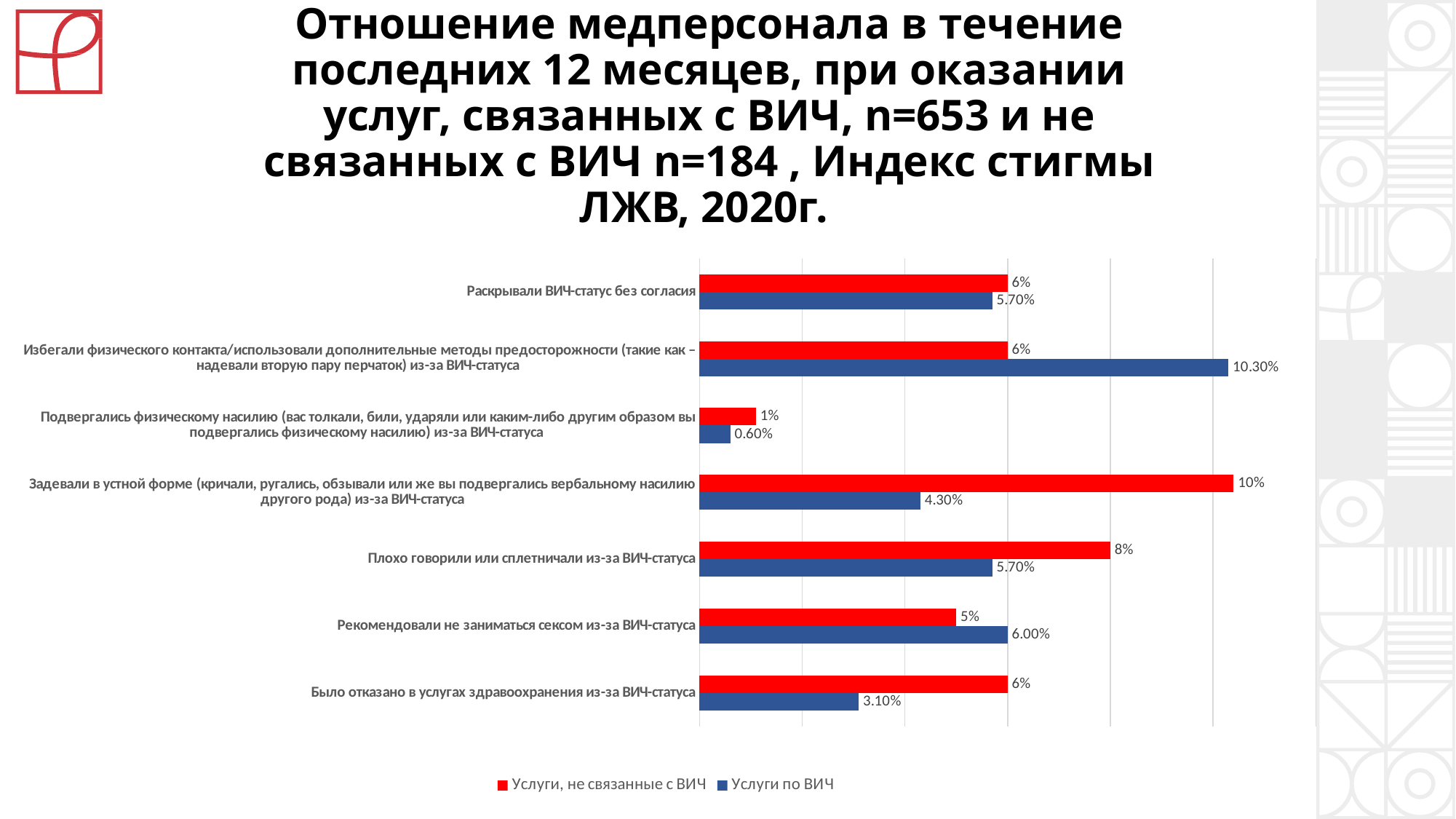
What kind of chart is shown on the slide? Bar chart What is the difference between the "Услуги по ВИЧ" values for "Избегали физического контакта..." and "Было отказано в услугах здравоохранения из-за ВИЧ-статуса"? 7.20% How many series does the legend list? 2 In the category "Рекомендовали не заниматься сексом из-за ВИЧ-статуса", which series has the larger value? Услуги по ВИЧ How many categories are shown on the chart? 7 What is the difference between the "Услуги, не связанные с ВИЧ" values for "Задевали в устной форме..." and "Подвергались физическому насилию..."? 9% What value is shown for "Услуги, не связанные с ВИЧ" in the category "Задевали в устной форме (кричали, ругались, обзывали или же вы подвергались вербальному насилию другого рода) из-за ВИЧ-статуса"? 10% What value is shown for "Услуги по ВИЧ" in the category "Избегали физического контакта/использовали дополнительные методы предосторожности (такие как – надевали вторую пару перчаток) из-за ВИЧ-статуса"? 10.30% What value is shown for "Услуги по ВИЧ" in the category "Было отказано в услугах здравоохранения из-за ВИЧ-статуса"? 3.10% Which category has the lowest value for the "Услуги, не связанные с ВИЧ" series? Подвергались физическому насилию (вас толкали, били, ударяли или каким-либо другим образом вы подвергались физическому насилию) из-за ВИЧ-статуса Which category has the highest value for the "Услуги по ВИЧ" series? Избегали физического контакта/использовали дополнительные методы предосторожности (такие как – надевали вторую пару перчаток) из-за ВИЧ-статуса In the category "Было отказано в услугах здравоохранения из-за ВИЧ-статуса", which series has the larger value? Услуги, не связанные с ВИЧ